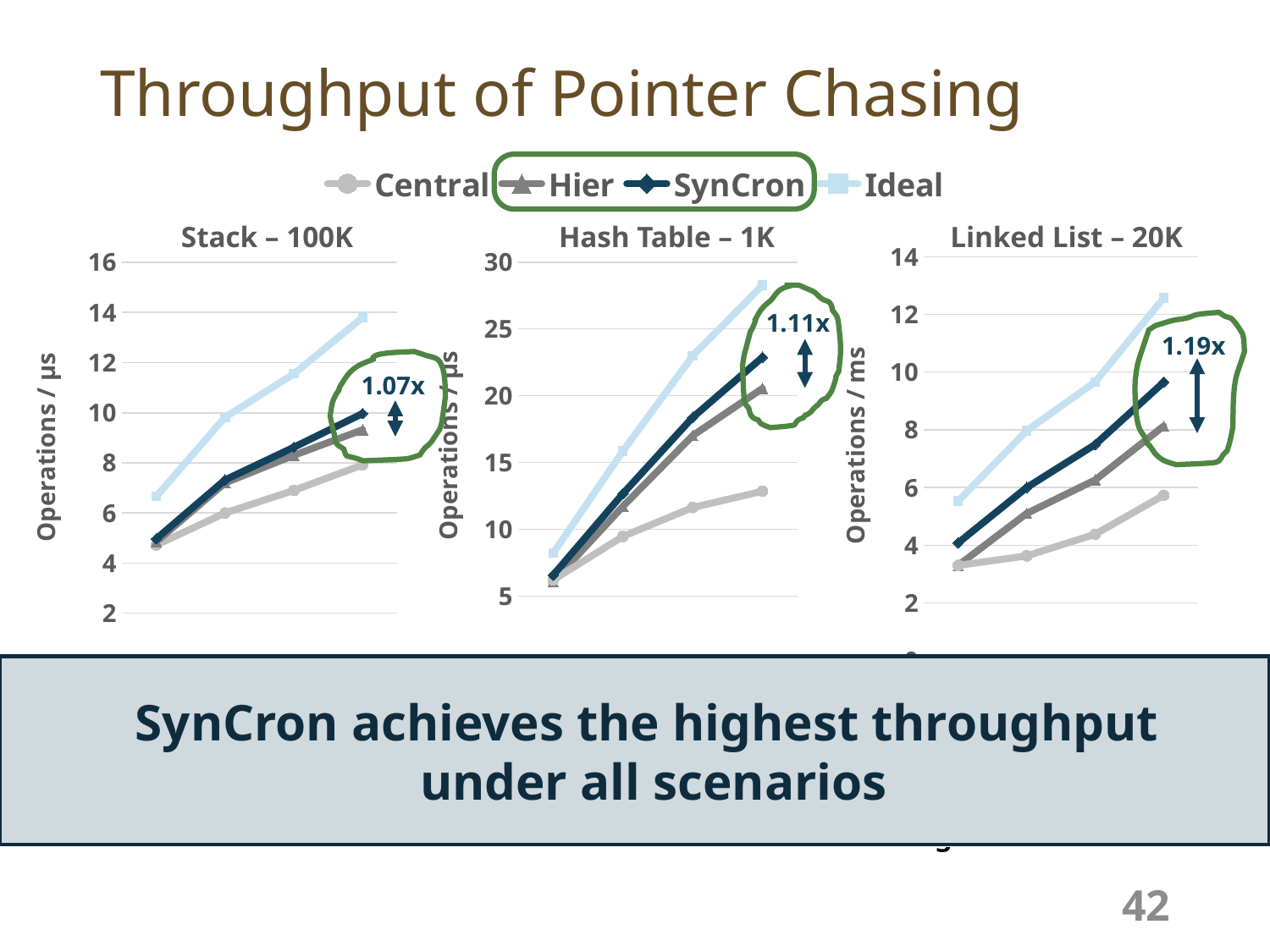
What speedup annotation is shown on the Linked List – 20K chart? 1.19x What kind of chart is the Stack – 100K chart? line chart In the Hash Table – 1K chart, which series reaches the highest value? Ideal In the Linked List – 20K chart, is the rightmost value of the SynCron series greater or less than 8? greater In the Stack – 100K chart, is the highest value of the Ideal series greater or less than 12? greater In the Linked List – 20K chart, which series has the lowest value at the rightmost point? Central How many series does the legend list? 4 In the Hash Table – 1K chart, is the rightmost value of the Central series greater or less than 15? less What is the y-axis label of the Linked List – 20K chart? Operations / ms In the Stack – 100K chart, at the rightmost point, which series is larger: SynCron or Central? SynCron In the Hash Table – 1K chart, do the values of the SynCron series rise or fall along the x axis? rise